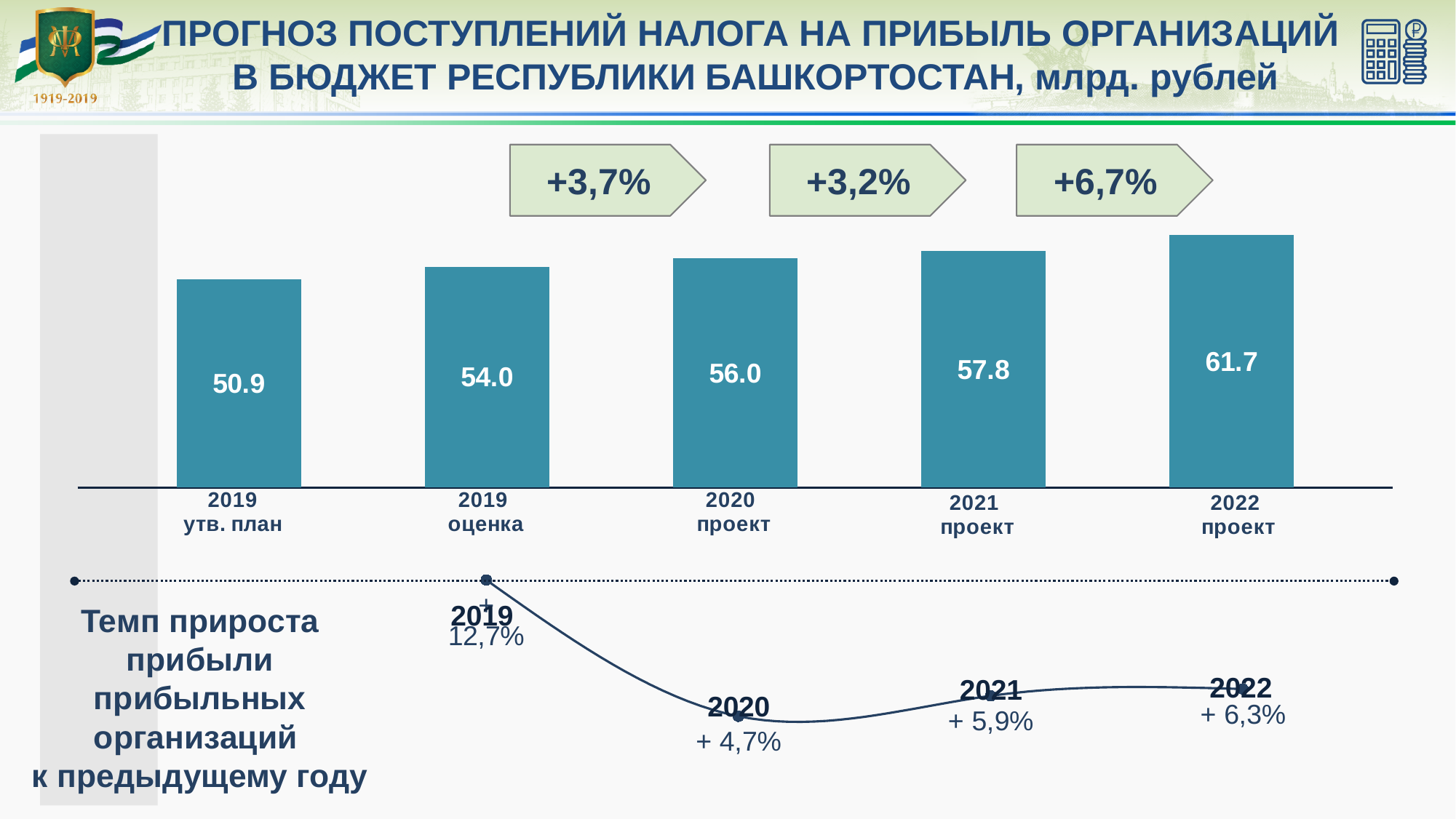
On the top bar chart, what is the difference between the values for 2022 проект and 2021 проект? 3.9 On the bottom line chart (Темп прироста прибыли прибыльных организаций), which year has the highest value? 2019 On the top bar chart, do the values rise or fall from left to right? rise On the top bar chart, which category has the highest value? 2022 проект How many bars are shown on the top bar chart? 5 On the top bar chart, what is the value for 2019 утв. план? 50.9 What kind of chart is the top chart on the slide? bar chart On the top bar chart, what is the value for 2019 оценка? 54.0 On the top bar chart, which is larger: the value for 2020 проект or the value for 2019 оценка? 2020 проект On the top bar chart, what is the value for 2022 проект? 61.7 On the bottom line chart (Темп прироста прибыли прибыльных организаций), what is the value for 2020? + 4,7% On the top bar chart, which category has the lowest value? 2019 утв. план